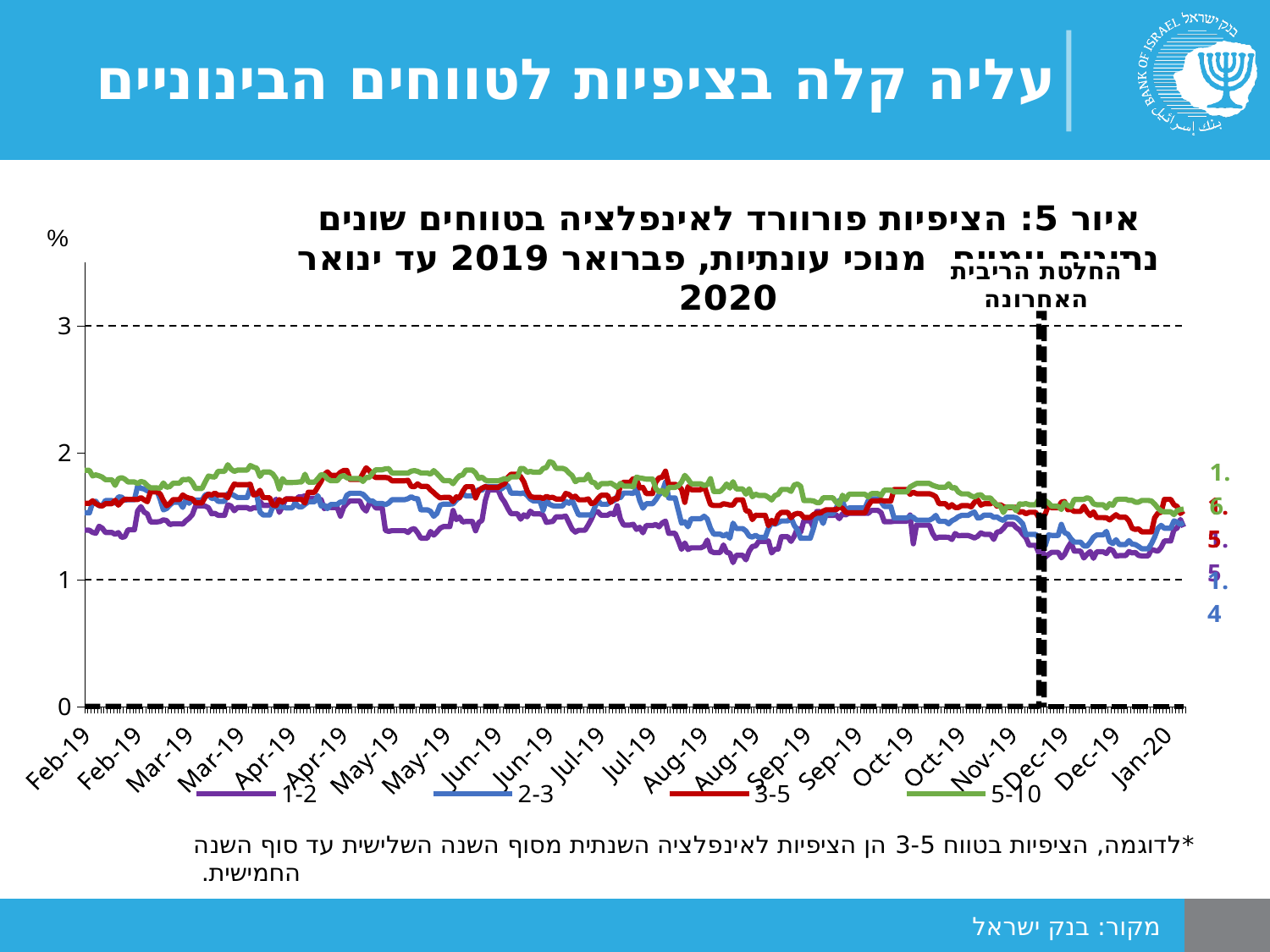
In Aug-19, which series has the larger value, 3-5 or 1-2? 3-5 Is the value for the 3-5 series in Jan-20 greater or less than 1? greater What kind of chart is shown on the slide? line chart Which series is the highest in Apr-19? 5-10 Is the value for the 1-2 series in Aug-19 greater or less than 1? greater Which colour is used for the 5-10 series? green In Feb-19, which series has the larger value, 5-10 or 1-2? 5-10 What unit is shown on the y axis? % Does the 5-10 series rise or fall from Feb-19 to Jan-20? fall Is the value for the 5-10 series in Feb-19 greater or less than 2? less How many series does the legend list? 4 Which series is the lowest in Aug-19? 1-2